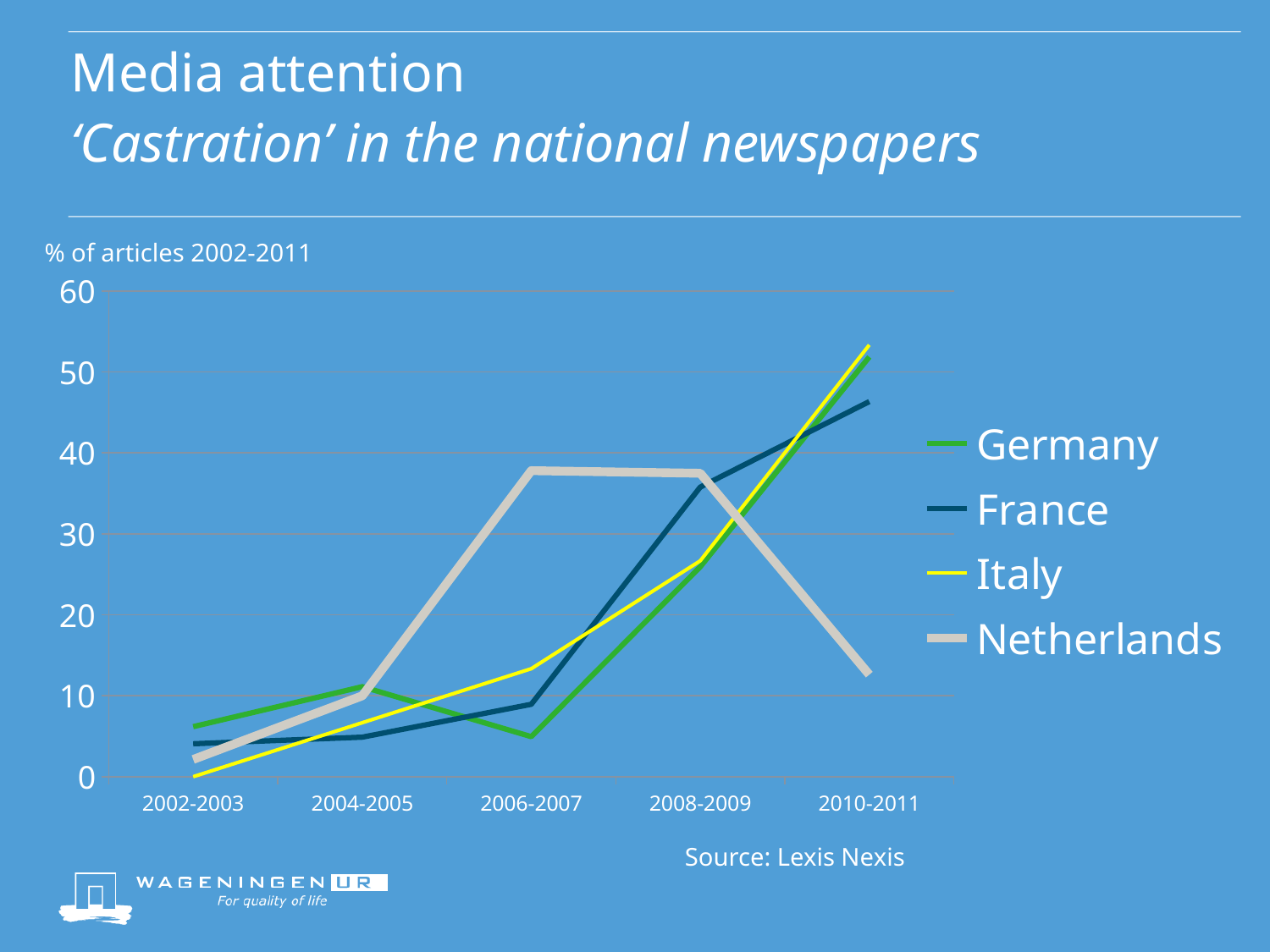
Is the value for Germany in 2006-2007 greater or less than 10? less Is the value for Netherlands in 2006-2007 greater or less than 30? greater How many series does the legend list? 4 What kind of chart is shown on the slide? line chart How many time periods are shown on the x axis? 5 In 2006-2007, which is larger: the value for Netherlands or the value for Germany? Netherlands Which country has the highest value in 2006-2007? Netherlands Which country has the lowest value in 2010-2011? Netherlands Is the value for Netherlands in 2010-2011 greater or less than 20? less What source is cited below the chart? Lexis Nexis Does the value for Netherlands rise or fall from 2008-2009 to 2010-2011? fall